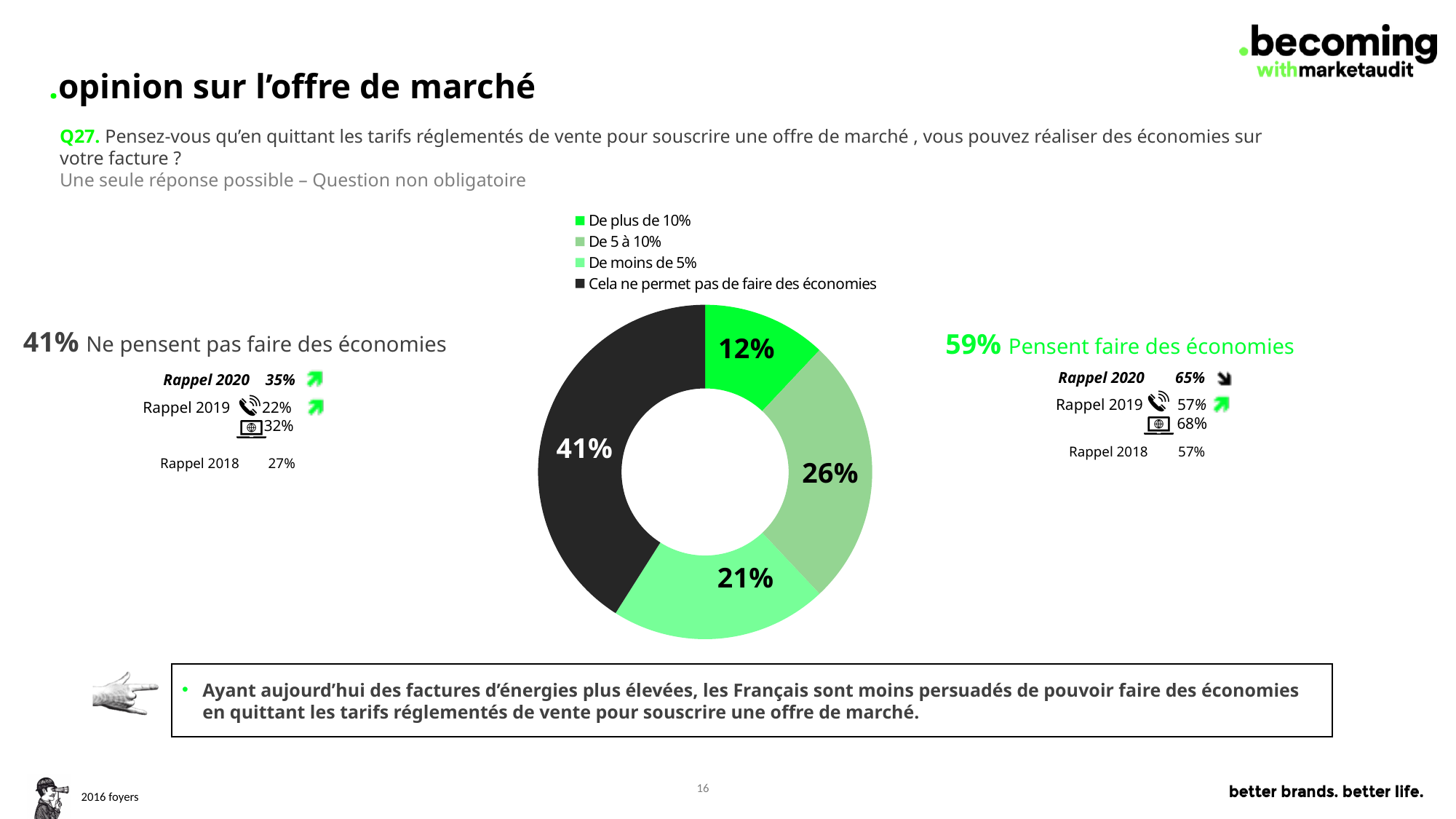
What kind of chart is shown on the slide? Pie chart (doughnut) What share of the pie is labelled "De moins de 5%"? 21% What share of the pie is labelled "De plus de 10%"? 12% How many categories does the pie chart show? 4 What colour is the slice for "Cela ne permet pas de faire des économies"? Black Which category has the largest slice of the pie? Cela ne permet pas de faire des économies What is the combined share of the three slices representing people who think they can make savings? 59% What is the difference in percentage points between the "De 5 à 10%" slice and the "De plus de 10%" slice? 14 percentage points Which slice is larger: "De 5 à 10%" or "De moins de 5%"? De 5 à 10% What share of the pie is labelled "De 5 à 10%"? 26% What share of the pie is labelled "Cela ne permet pas de faire des économies"? 41% Which category has the smallest slice of the pie? De plus de 10%